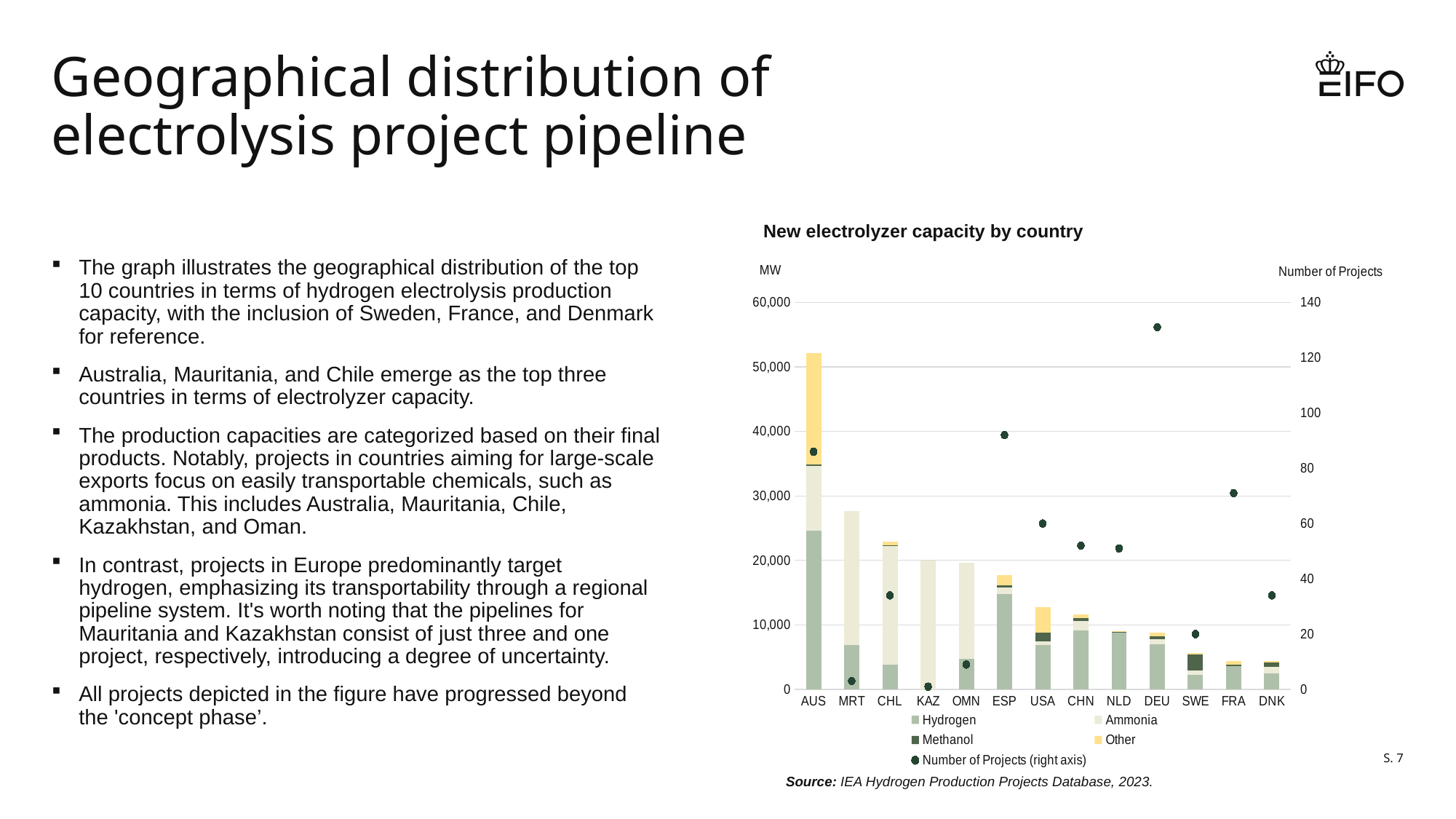
Is the number of projects for DEU greater or less than 120? greater Is the total electrolyzer capacity bar for MRT greater or less than 30,000 MW? less What is the title of the chart? New electrolyzer capacity by country Which has the larger total electrolyzer capacity bar, MRT or CHL? MRT Which country has the lowest number of projects (right axis)? KAZ Which country has the tallest bar for new electrolyzer capacity? AUS How many series does the chart legend list? 5 Which country has the highest number of projects (right axis)? DEU Which country has more projects, ESP or USA? ESP How many countries are shown on the x axis of the chart? 13 What kind of chart is shown on the slide? Stacked bar chart with a line/dot series on a secondary axis Is the total electrolyzer capacity bar for AUS greater or less than 50,000 MW? greater